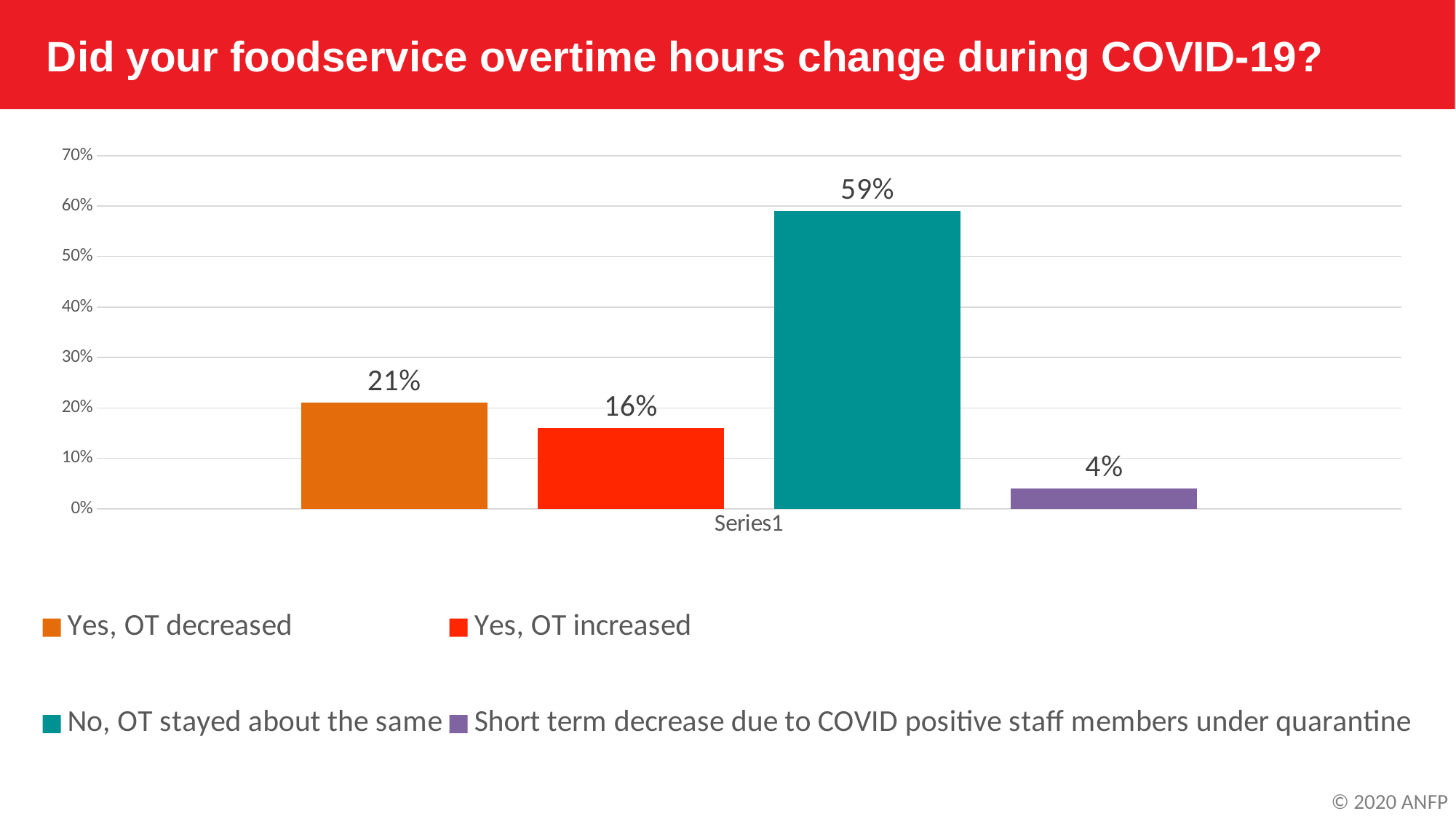
Is the value for 'No, OT stayed about the same' greater or less than 50%? greater What is the title of the slide? Did your foodservice overtime hours change during COVID-19? How many response categories are shown in the chart? 4 Which response has the highest percentage? No, OT stayed about the same What is the difference in percentage points between 'No, OT stayed about the same' and 'Yes, OT decreased'? 38 percentage points What percentage of respondents said 'Yes, OT decreased'? 21% What type of chart is shown on the slide? Bar chart Which is larger: the percentage for 'Yes, OT decreased' or 'Yes, OT increased'? Yes, OT decreased What percentage of respondents said 'No, OT stayed about the same'? 59% Which response has the lowest percentage? Short term decrease due to COVID positive staff members under quarantine What percentage of respondents reported a short term decrease due to COVID positive staff members under quarantine? 4% What percentage of respondents said 'Yes, OT increased'? 16%